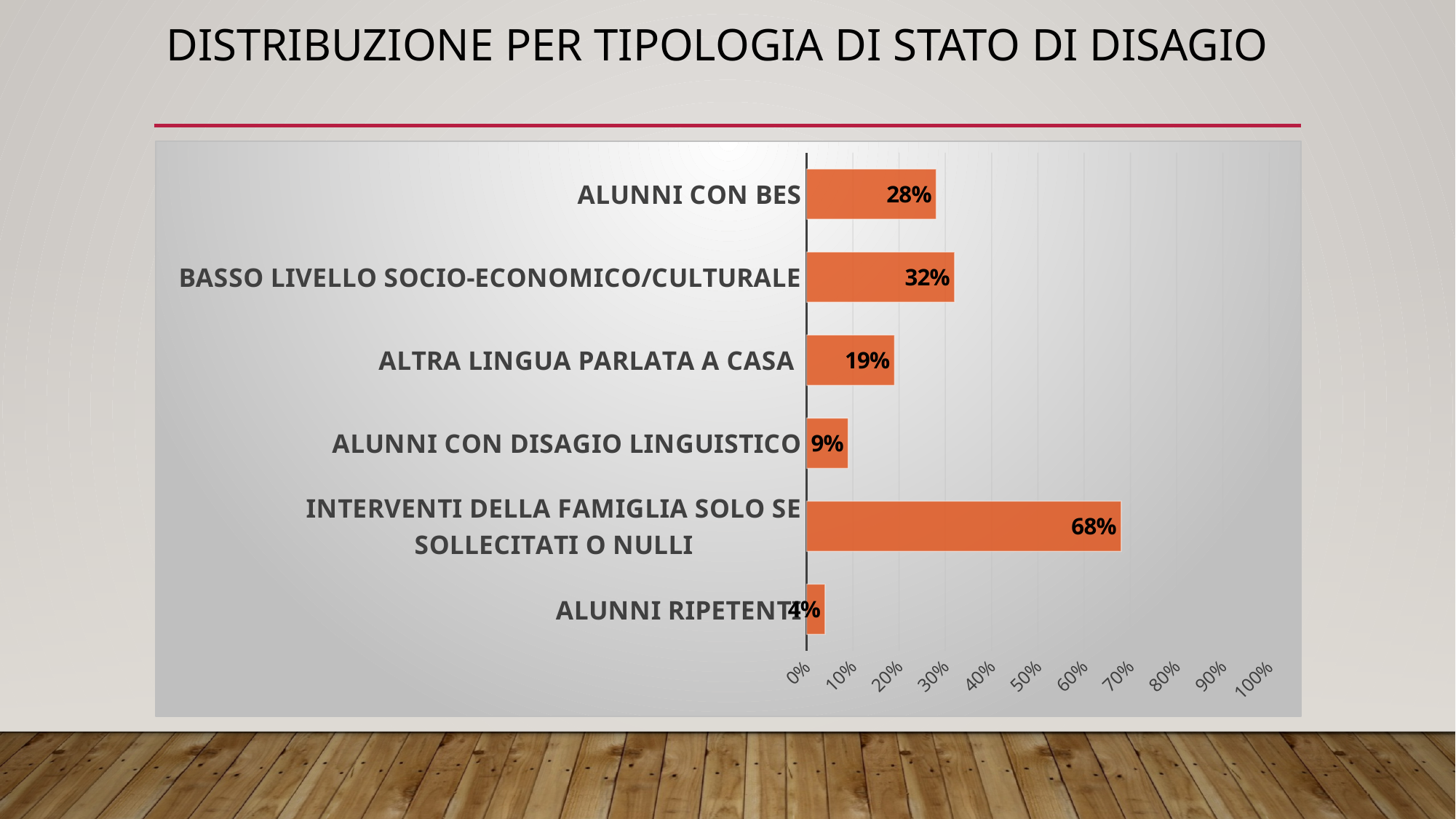
What is the difference between the values for INTERVENTI DELLA FAMIGLIA SOLO SE SOLLECITATI O NULLI and BASSO LIVELLO SOCIO-ECONOMICO/CULTURALE? 36% What is the title of the slide? DISTRIBUZIONE PER TIPOLOGIA DI STATO DI DISAGIO Which category has the lowest value? ALUNNI RIPETENTI What kind of chart is shown on the slide? bar chart Which category has the highest value? INTERVENTI DELLA FAMIGLIA SOLO SE SOLLECITATI O NULLI Is the value for ALUNNI CON DISAGIO LINGUISTICO greater or less than 20%? less How many categories are shown in the chart? 6 What is the value for INTERVENTI DELLA FAMIGLIA SOLO SE SOLLECITATI O NULLI? 68% What is the value for ALTRA LINGUA PARLATA A CASA? 19% Which is larger, the value for ALUNNI CON BES or the value for ALTRA LINGUA PARLATA A CASA? ALUNNI CON BES What is the value for BASSO LIVELLO SOCIO-ECONOMICO/CULTURALE? 32% What is the value for ALUNNI CON BES? 28%